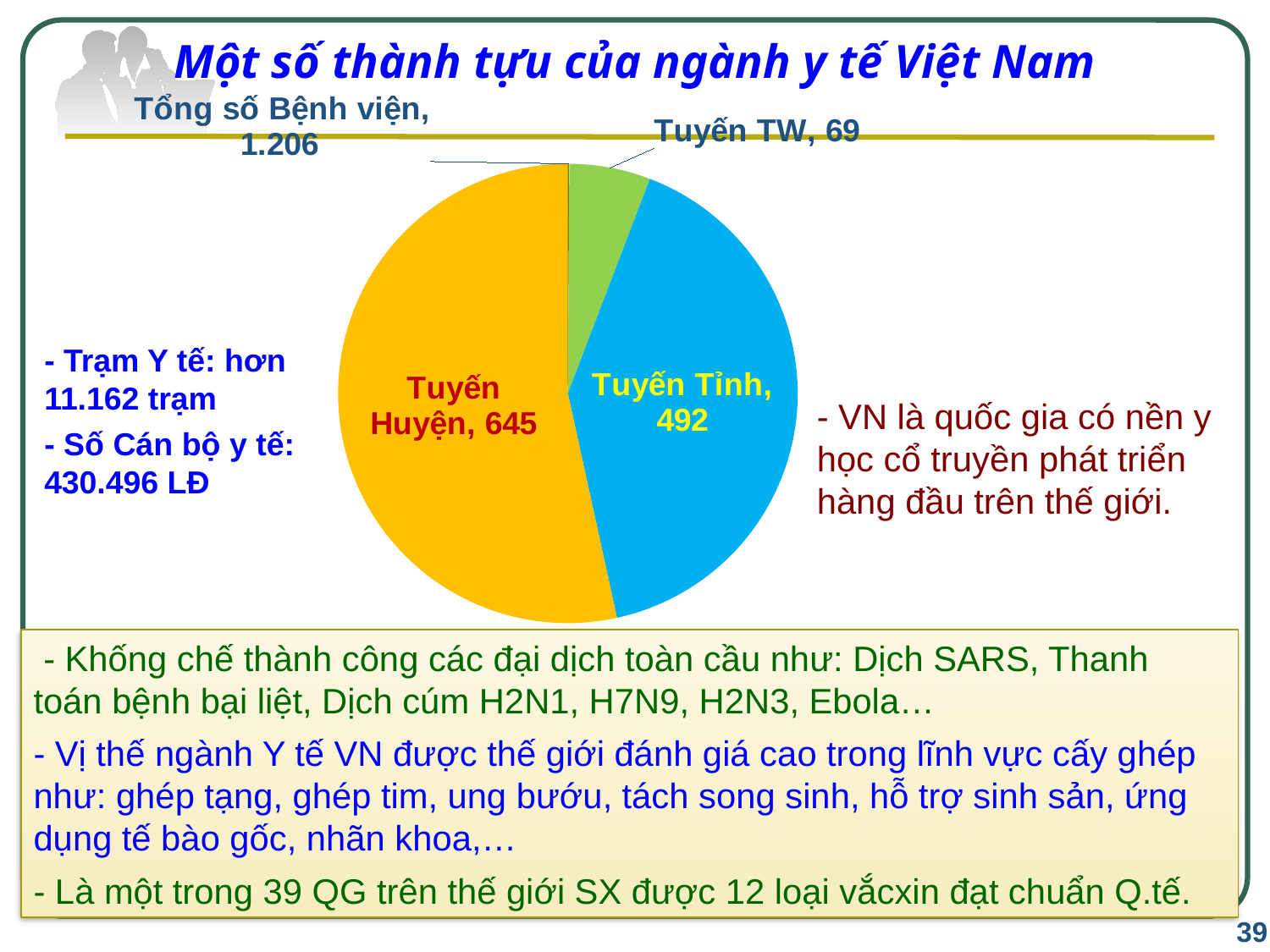
What is the value for Tuyến TW in the pie chart? 69 What is the difference between the values for Tuyến Huyện and Tuyến Tỉnh? 153 What is the difference between the values for Tuyến Tỉnh and Tuyến TW? 423 Which category has the smallest slice in the pie chart? Tuyến TW Which is larger in the pie chart, Tuyến Tỉnh or Tuyến TW? Tuyến Tỉnh What colour is the Tuyến Tỉnh slice in the pie chart? blue Which category has the largest slice in the pie chart? Tuyến Huyện What is the value for Tuyến Tỉnh in the pie chart? 492 What total number of hospitals (Tổng số Bệnh viện) is printed above the pie chart? 1.206 What kind of chart is shown on the slide? pie chart Which is larger in the pie chart, Tuyến Huyện or Tuyến Tỉnh? Tuyến Huyện What is the value for Tuyến Huyện in the pie chart? 645